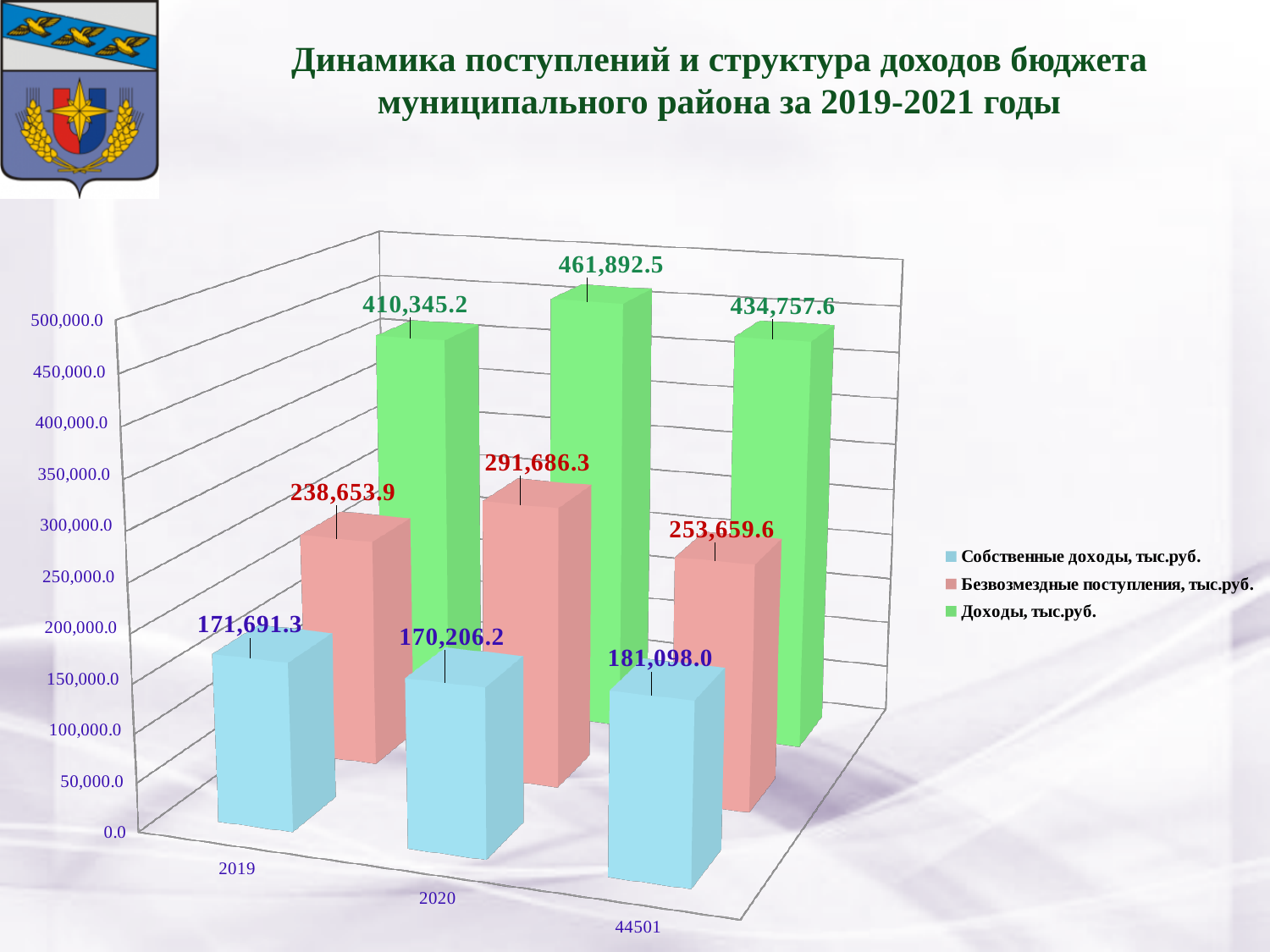
Which is larger: Безвозмездные поступления, тыс.руб. in 2020 or in 2019? 2020 What is the value of Доходы, тыс.руб. for 2020? 461,892.5 What is the value of Собственные доходы, тыс.руб. for 2019? 171,691.3 How many categories are shown on the x axis? 3 What is the value of Безвозмездные поступления, тыс.руб. for the category labelled 44501? 253,659.6 How many series does the legend list? 3 Which category has the lowest value for Собственные доходы, тыс.руб.? 2020 What kind of chart is shown on the slide? Bar chart What is the difference between Доходы, тыс.руб. in 2020 and in 2019? 51,547.3 Which category has the highest value for Доходы, тыс.руб.? 2020 Which series is shown in green? Доходы, тыс.руб. What is the difference between Собственные доходы, тыс.руб. for 44501 and for 2020? 10,891.8